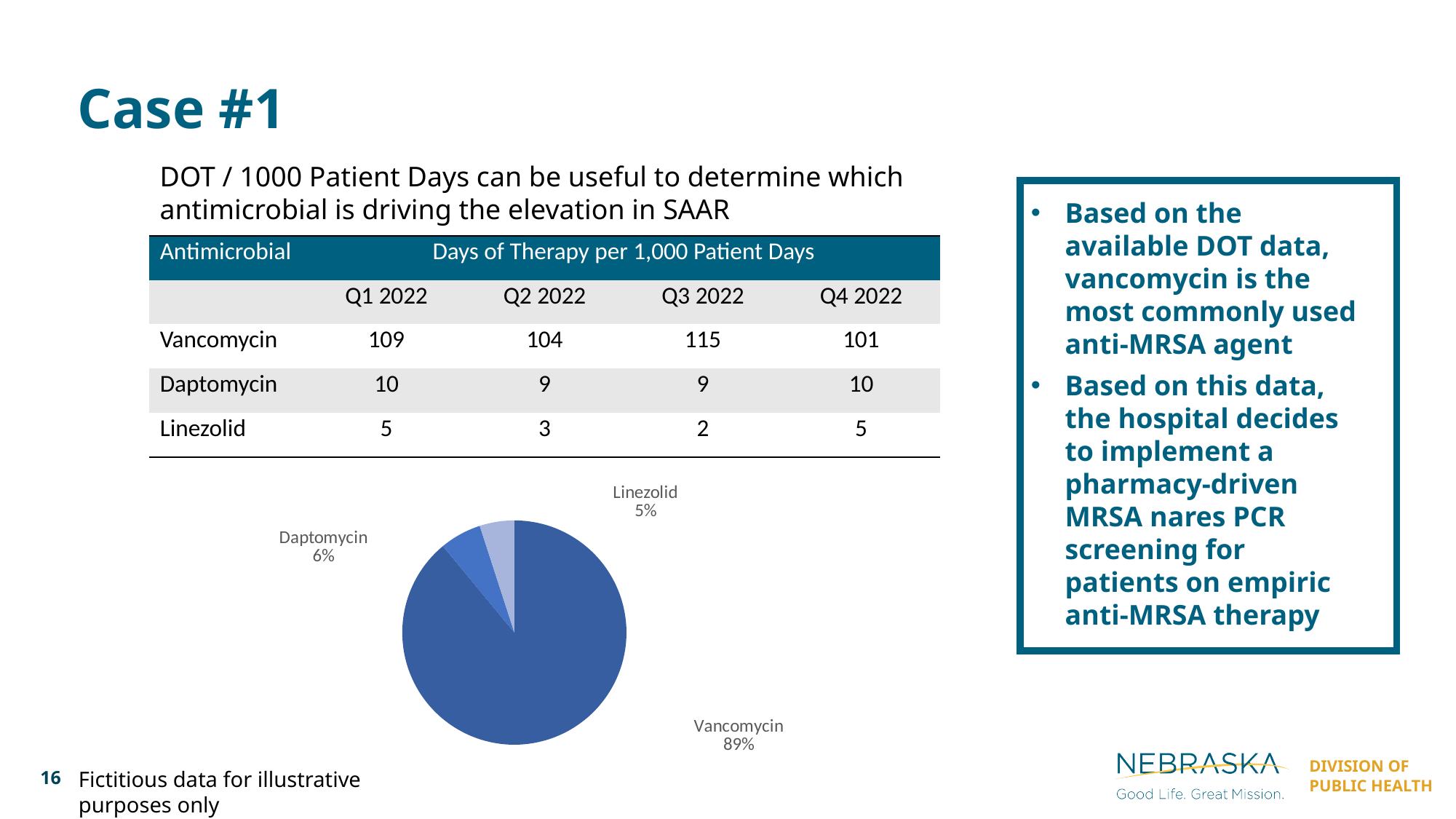
What kind of chart is shown on the slide? pie chart How many slices does the pie chart have? 3 Is the Vancomycin share in the pie chart greater or less than 50%? greater In the pie chart, what is the difference in percentage points between the Vancomycin slice and the Daptomycin slice? 83 Which antimicrobial has the largest slice in the pie chart? Vancomycin What share of the pie chart does Vancomycin account for? 89% In the pie chart, what is the difference in percentage points between the Daptomycin slice and the Linezolid slice? 1 What share of the pie chart does Daptomycin account for? 6% Which antimicrobial has the smallest slice in the pie chart? Linezolid What share of the pie chart does Linezolid account for? 5% In the pie chart, which is larger, the Daptomycin slice or the Linezolid slice? Daptomycin Which slice of the pie chart is shown in the lightest blue colour? Linezolid